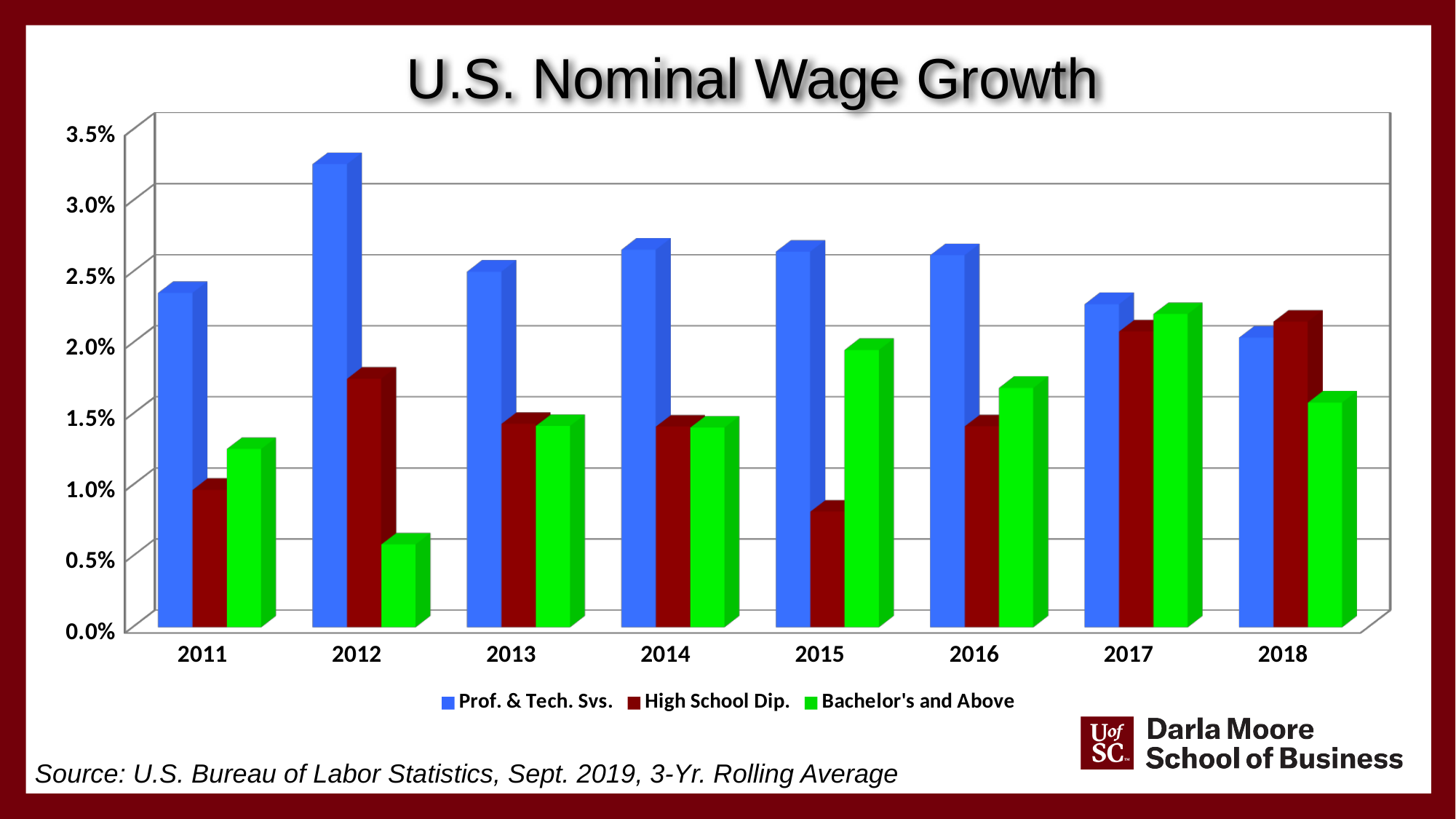
In 2015, which is larger: High School Dip. or Bachelor's and Above? Bachelor's and Above Is the Prof. & Tech. Svs. value for 2012 greater or less than 3.0%? greater In which year is the Bachelor's and Above value highest? 2017 In which year is the Prof. & Tech. Svs. value highest? 2012 What kind of chart is shown on the slide? bar chart In which year is the High School Dip. value lowest? 2015 In which year is the Bachelor's and Above value lowest? 2012 Is the High School Dip. value for 2015 greater or less than 1.0%? less How many series does the legend list? 3 Does the Prof. & Tech. Svs. value rise or fall from 2014 to 2018? fall How many years are shown on the x axis? 8 Is the Bachelor's and Above value for 2012 greater or less than 1.0%? less